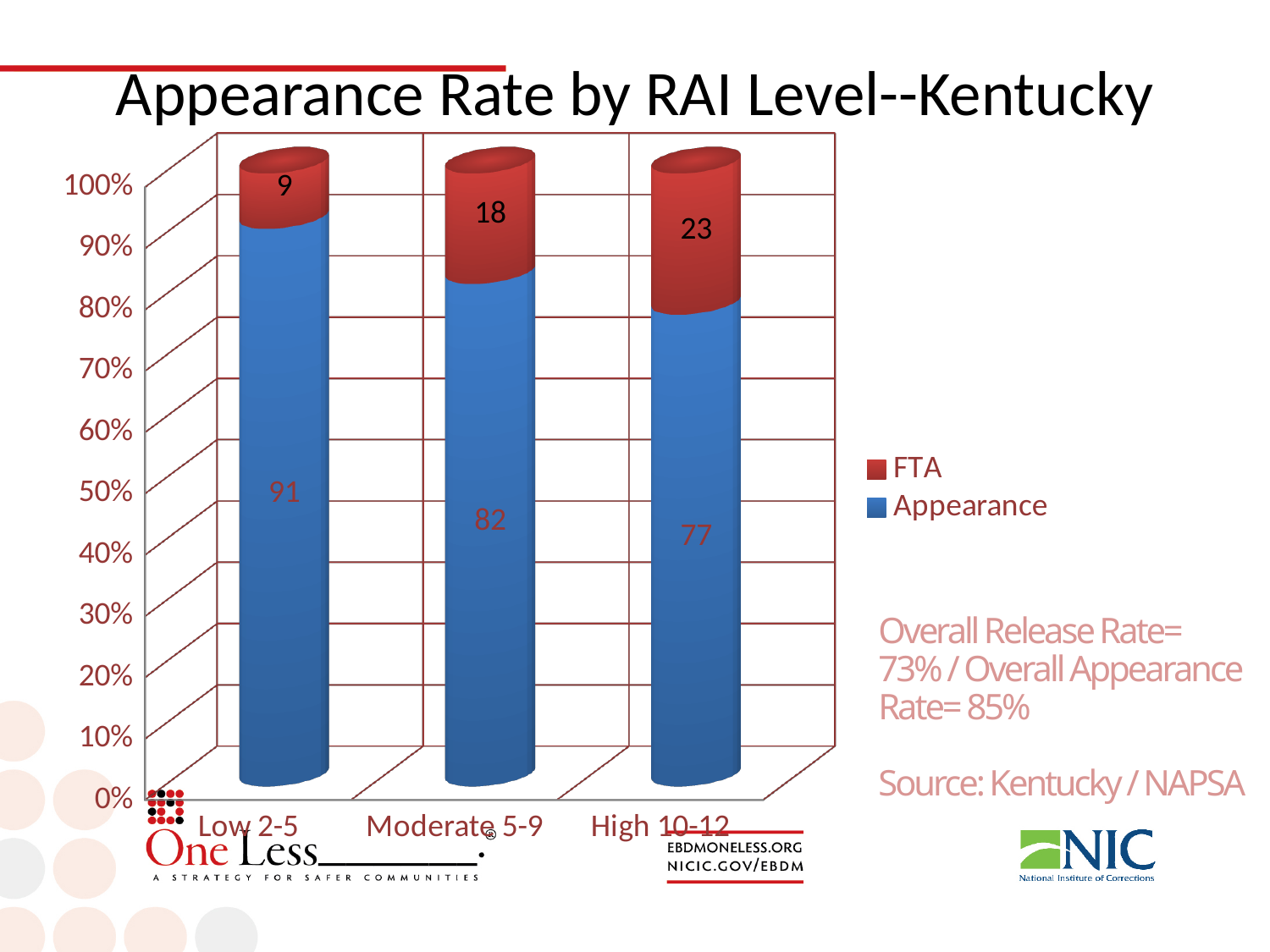
How many series does the legend list? 2 Which category has the lowest FTA value? Low 2-5 Which category has the highest Appearance value? Low 2-5 What is the Appearance value for the Low 2-5 category? 91 What kind of chart is shown on the slide? Stacked bar chart What is the FTA value for the High 10-12 category? 23 What is the title of the chart? Appearance Rate by RAI Level--Kentucky Do the Appearance values rise or fall from Low 2-5 to High 10-12? Fall What is the FTA value for the Moderate 5-9 category? 18 How many categories are shown on the x axis? 3 Which is larger, the FTA value for Moderate 5-9 or the FTA value for High 10-12? High 10-12 What is the difference between the Appearance values for Low 2-5 and High 10-12? 14